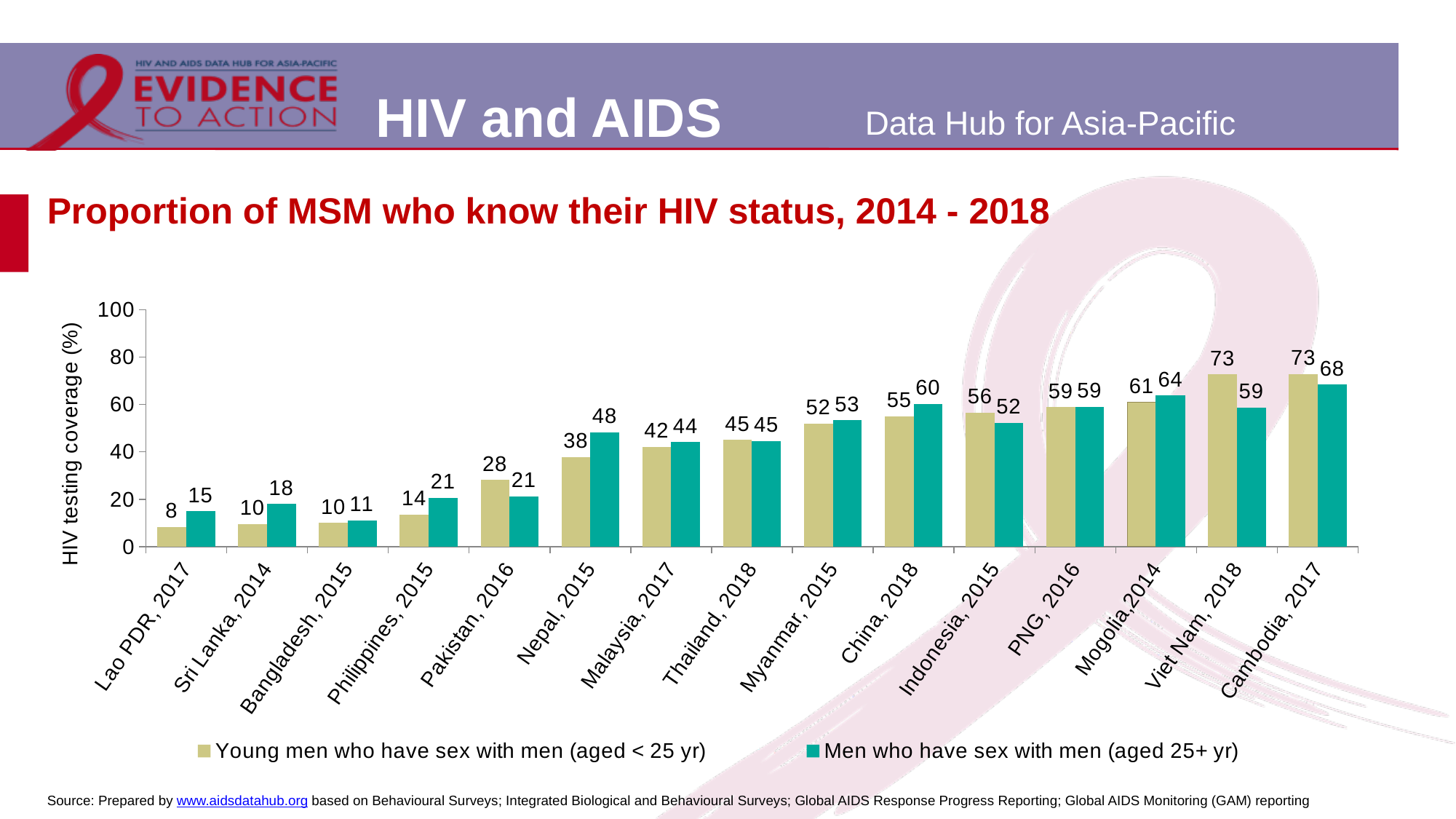
In Indonesia, 2015, which group has the higher HIV testing coverage: young MSM (aged < 25 yr) or MSM (aged 25+ yr)? Young men who have sex with men (aged < 25 yr) What is the HIV testing coverage for men who have sex with men (aged 25+ yr) in Viet Nam, 2018? 59 What is the label of the y axis of the chart? HIV testing coverage (%) Do the values for men who have sex with men (aged 25+ yr) generally rise or fall from Lao PDR to Cambodia along the x axis? Rise What is the difference between the two series' values for Pakistan, 2016? 7 What is the HIV testing coverage for young men who have sex with men (aged < 25 yr) in Nepal, 2015? 38 Which country has the lowest HIV testing coverage for young men who have sex with men (aged < 25 yr)? Lao PDR, 2017 How many series does the legend list? 2 Which country has the highest HIV testing coverage for men who have sex with men (aged 25+ yr)? Cambodia, 2017 What kind of chart is shown on the slide? Bar chart How many countries are shown on the x axis of the chart? 15 Which country has the lowest HIV testing coverage for men who have sex with men (aged 25+ yr)? Bangladesh, 2015